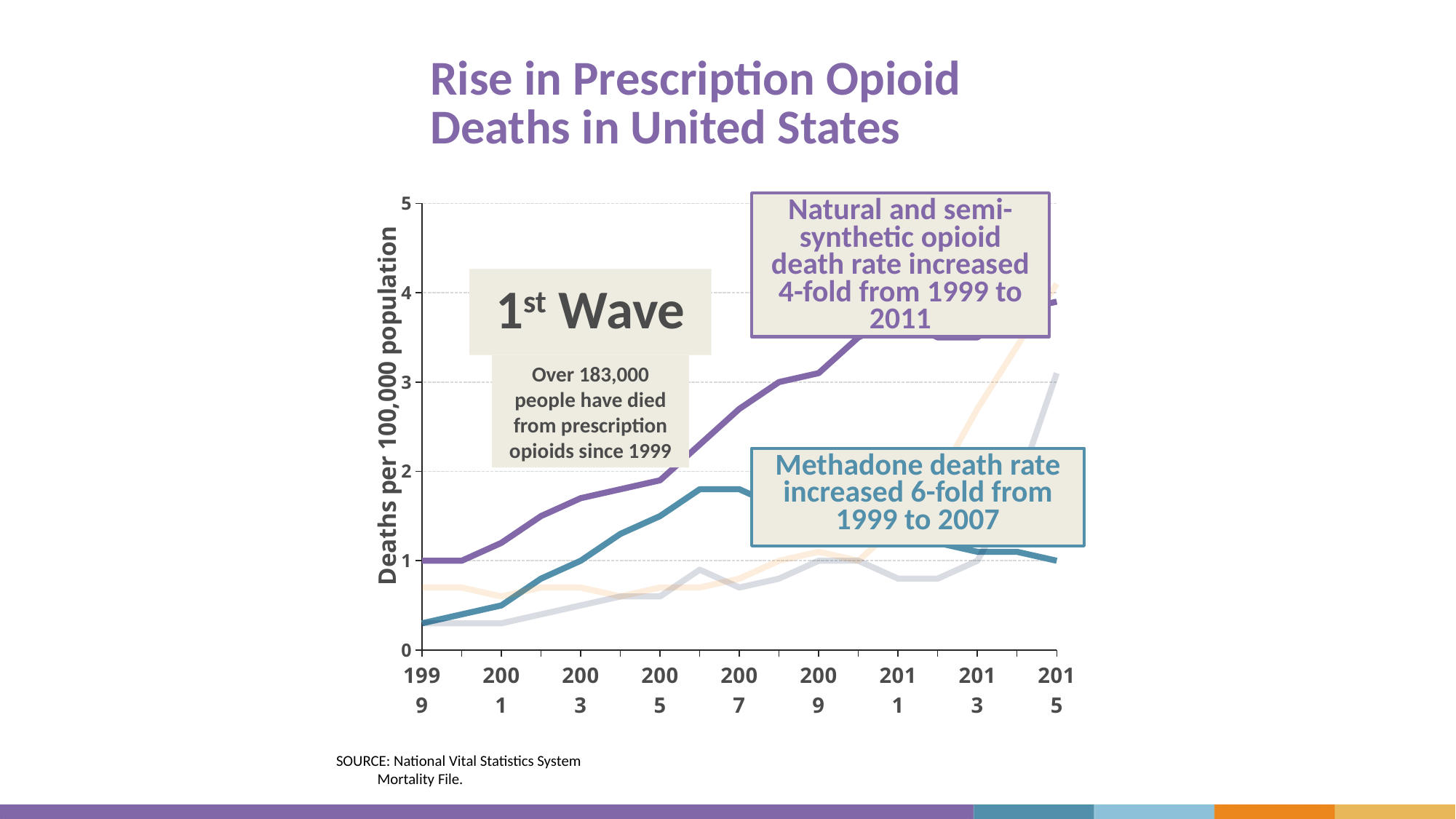
Is the value of the purple (natural and semi-synthetic opioid) line in 2007 greater or less than 2? greater In 2009, which line is higher: the purple (natural and semi-synthetic opioid) line or the teal (methadone) line? purple (natural and semi-synthetic opioid) Is the value of the teal (methadone) line in 2007 greater or less than 1? greater What is the label on the vertical axis of the chart? Deaths per 100,000 population Is the value of the teal (methadone) line in 2001 greater or less than 1? less What is the value of the teal (methadone) line in 2015? 1 What is the value of the purple (natural and semi-synthetic opioid) line in 1999? 1 What kind of chart is shown on the slide? line chart How many year labels are shown on the horizontal axis? 9 What is the title of the slide's chart? Rise in Prescription Opioid Deaths in United States Does the purple (natural and semi-synthetic opioid) line generally rise or fall from 1999 to 2015? rise